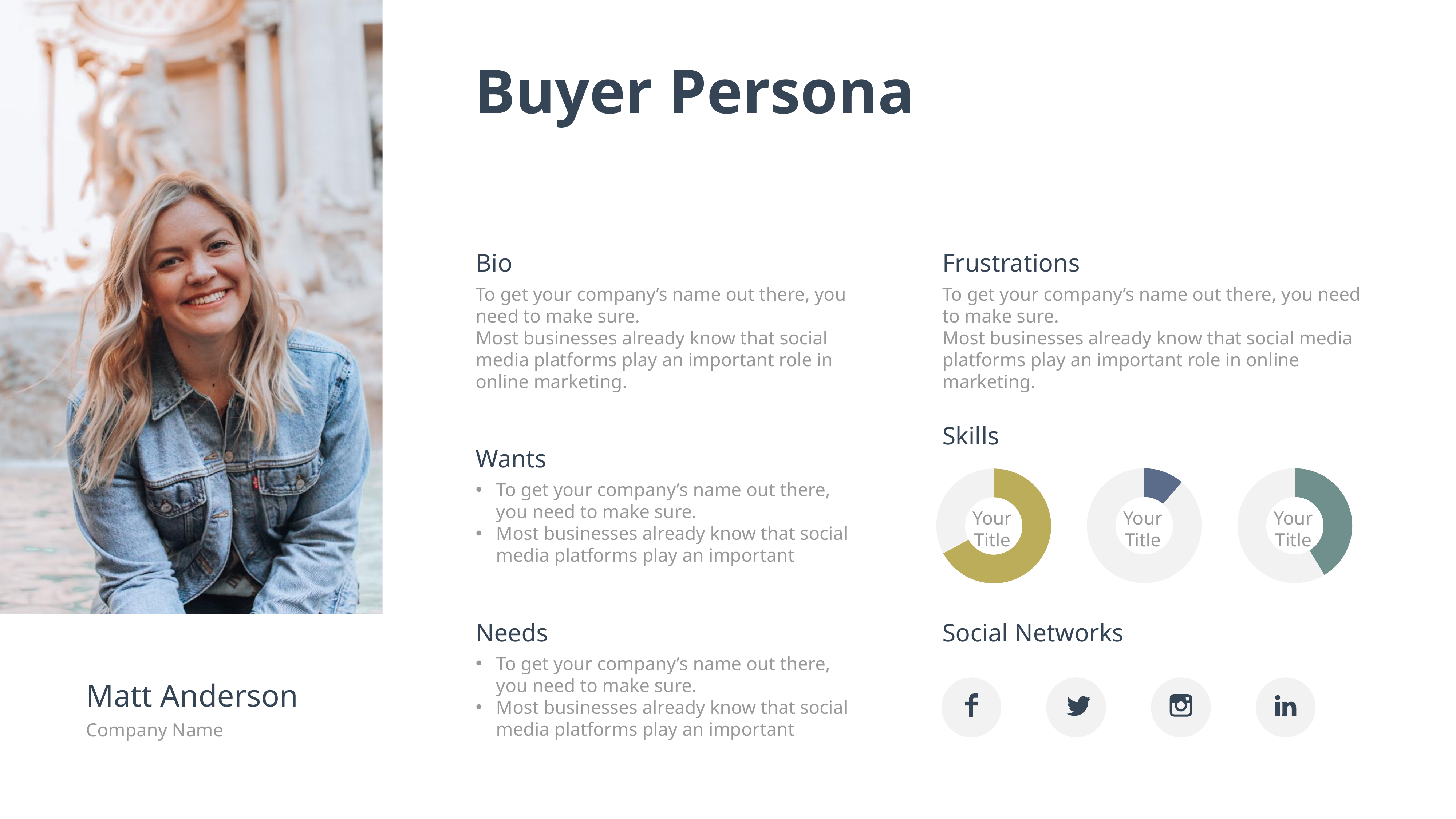
Which of the three Skills donut charts has the smallest filled portion? The middle one How many donut charts are shown under the Skills heading? 3 What text appears in the centre of each Skills donut chart? Your Title Is the filled portion of the left Skills donut chart larger or smaller than that of the right one? Larger Is the filled portion of the left Skills donut chart larger or smaller than that of the middle one? Larger What colour is the filled portion of the left Skills donut chart? Olive/gold Which of the three Skills donut charts has the largest filled portion? The left one What kind of chart is used to show the skills on the slide? Donut chart Is the filled portion of the right Skills donut chart larger or smaller than that of the middle one? Larger